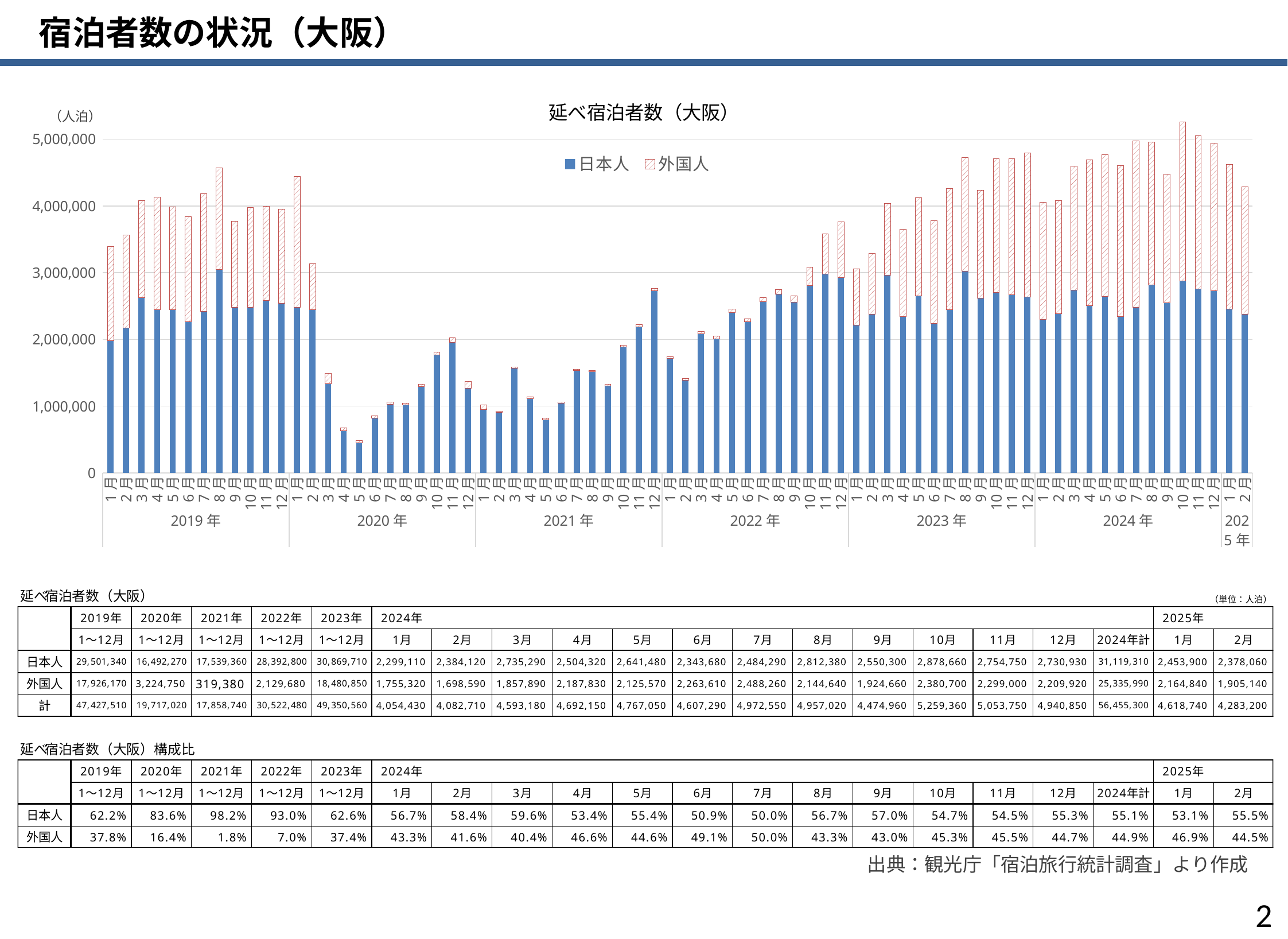
Is the total value for 2024年10月 greater or less than 5,000,000? greater Which month has the lowest total bar in the whole chart? 2020年5月 What is the title of the chart? 延べ宿泊者数（大阪） Is the total value for 2020年5月 greater or less than 1,000,000? less What is the 外国人 value for 2025年2月? 1,905,140 What is the difference between the 2024年計 values for 日本人 and 外国人? 5,783,320 What kind of chart is shown on the slide? bar chart What are the two series named in the chart legend? 日本人, 外国人 For 2024年1月, which is larger, 日本人 or 外国人? 日本人 What is the total (計) number of 延べ宿泊者数 for 2024年10月? 5,259,360 Which month of 2024 has the highest total 延べ宿泊者数? 10月 How many series does the legend of the chart list? 2